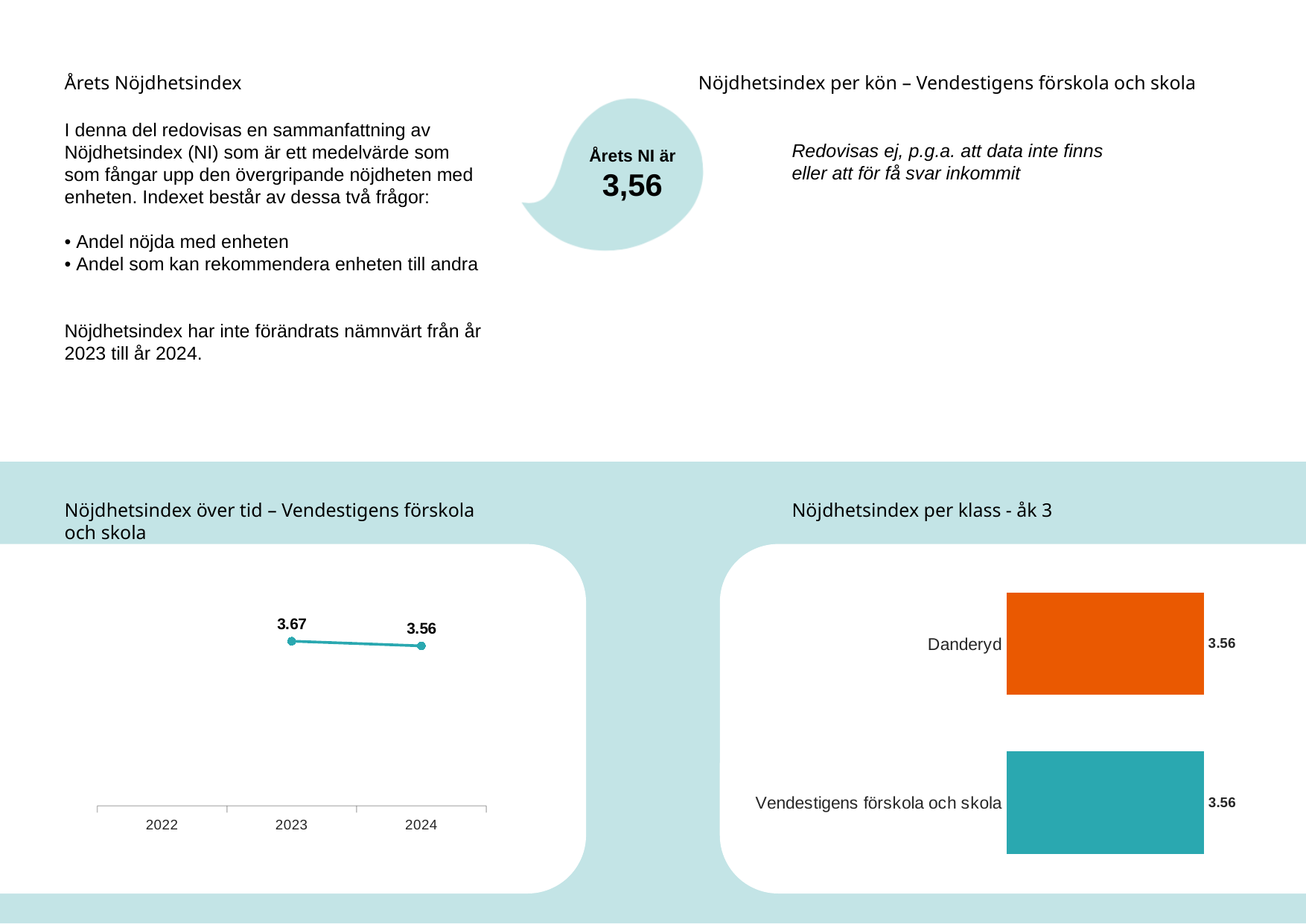
In the chart 'Nöjdhetsindex över tid – Vendestigens förskola och skola', what is the value for 2023? 3.67 What kind of chart is 'Nöjdhetsindex över tid – Vendestigens förskola och skola'? line chart In the chart 'Nöjdhetsindex per klass - åk 3', how many categories are shown? 2 In the chart 'Nöjdhetsindex per klass - åk 3', what is the value for Danderyd? 3.56 In the chart 'Nöjdhetsindex över tid – Vendestigens förskola och skola', which year has the higher value, 2023 or 2024? 2023 In the chart 'Nöjdhetsindex över tid – Vendestigens förskola och skola', does the value rise or fall from 2023 to 2024? fall What kind of chart is 'Nöjdhetsindex per klass - åk 3'? bar chart In the chart 'Nöjdhetsindex över tid – Vendestigens förskola och skola', what is the value for 2024? 3.56 In the chart 'Nöjdhetsindex över tid – Vendestigens förskola och skola', how many years are shown on the x axis? 3 In the chart 'Nöjdhetsindex per klass - åk 3', what is the value for Vendestigens förskola och skola? 3.56 In the chart 'Nöjdhetsindex per klass - åk 3', what is the difference between the values for Danderyd and Vendestigens förskola och skola? 0 In the chart 'Nöjdhetsindex över tid – Vendestigens förskola och skola', what is the difference between the 2023 and 2024 values? 0.11